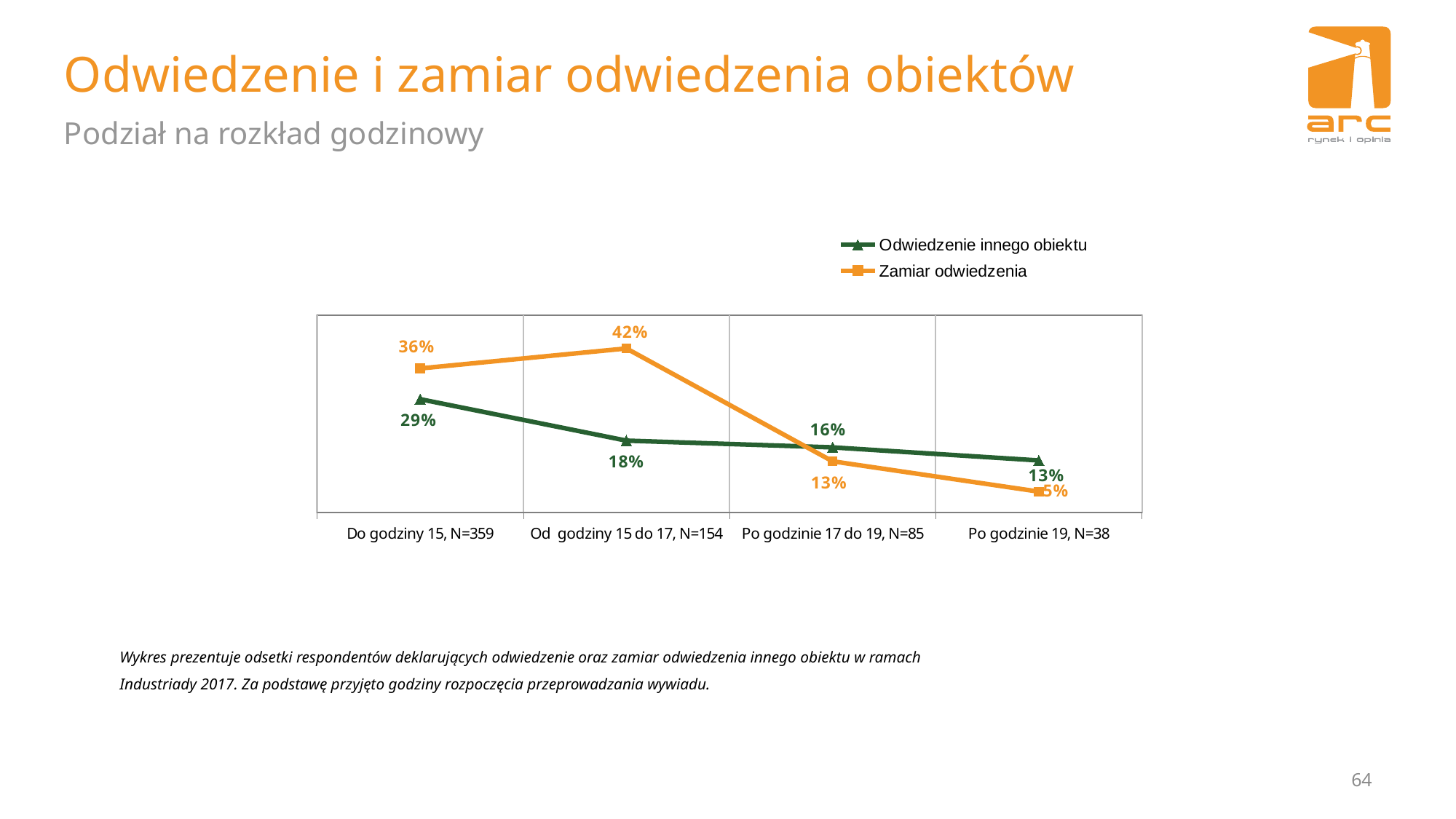
What is the value of 'Zamiar odwiedzenia' for 'Po godzinie 19, N=38'? 5% How many categories are shown on the x axis? 4 Which category has the lowest value for 'Odwiedzenie innego obiektu'? Po godzinie 19, N=38 Which colour is used for the 'Zamiar odwiedzenia' series? orange What is the difference between 'Zamiar odwiedzenia' and 'Odwiedzenie innego obiektu' for 'Do godziny 15, N=359'? 7% What type of chart is shown on the slide? line chart What is the value of 'Odwiedzenie innego obiektu' for 'Do godziny 15, N=359'? 29% How many series does the legend list? 2 What is the value of 'Zamiar odwiedzenia' for 'Od godziny 15 do 17, N=154'? 42% Does the 'Odwiedzenie innego obiektu' series rise or fall across the categories from left to right? fall Which category has the highest value for 'Zamiar odwiedzenia'? Od godziny 15 do 17, N=154 For 'Po godzinie 17 do 19, N=85', which series has the larger value, 'Odwiedzenie innego obiektu' or 'Zamiar odwiedzenia'? Odwiedzenie innego obiektu